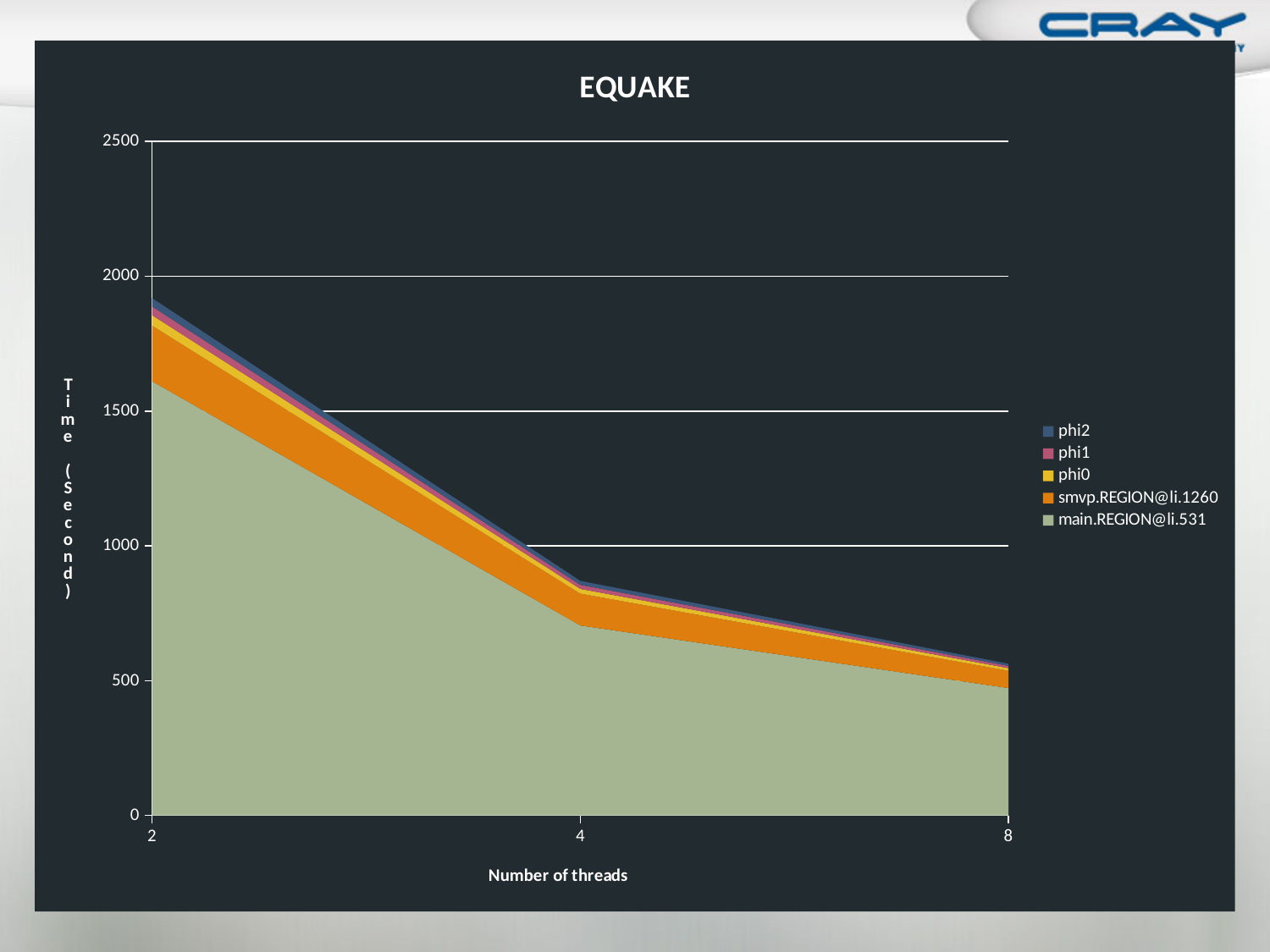
Is the value for main.REGION@li.531 at 4 threads greater or less than 500? greater Is the total stacked time at 2 threads greater or less than 2000? less Is the value for main.REGION@li.531 at 2 threads greater or less than 1500? greater Which series occupies the largest area of the chart? main.REGION@li.531 Does the total time rise or fall as the number of threads increases? fall What kind of chart is shown on the slide? area chart What is the title of the chart? EQUAKE How many series does the legend list? 5 What is the label of the x axis? Number of threads How many thread counts are plotted along the x axis? 3